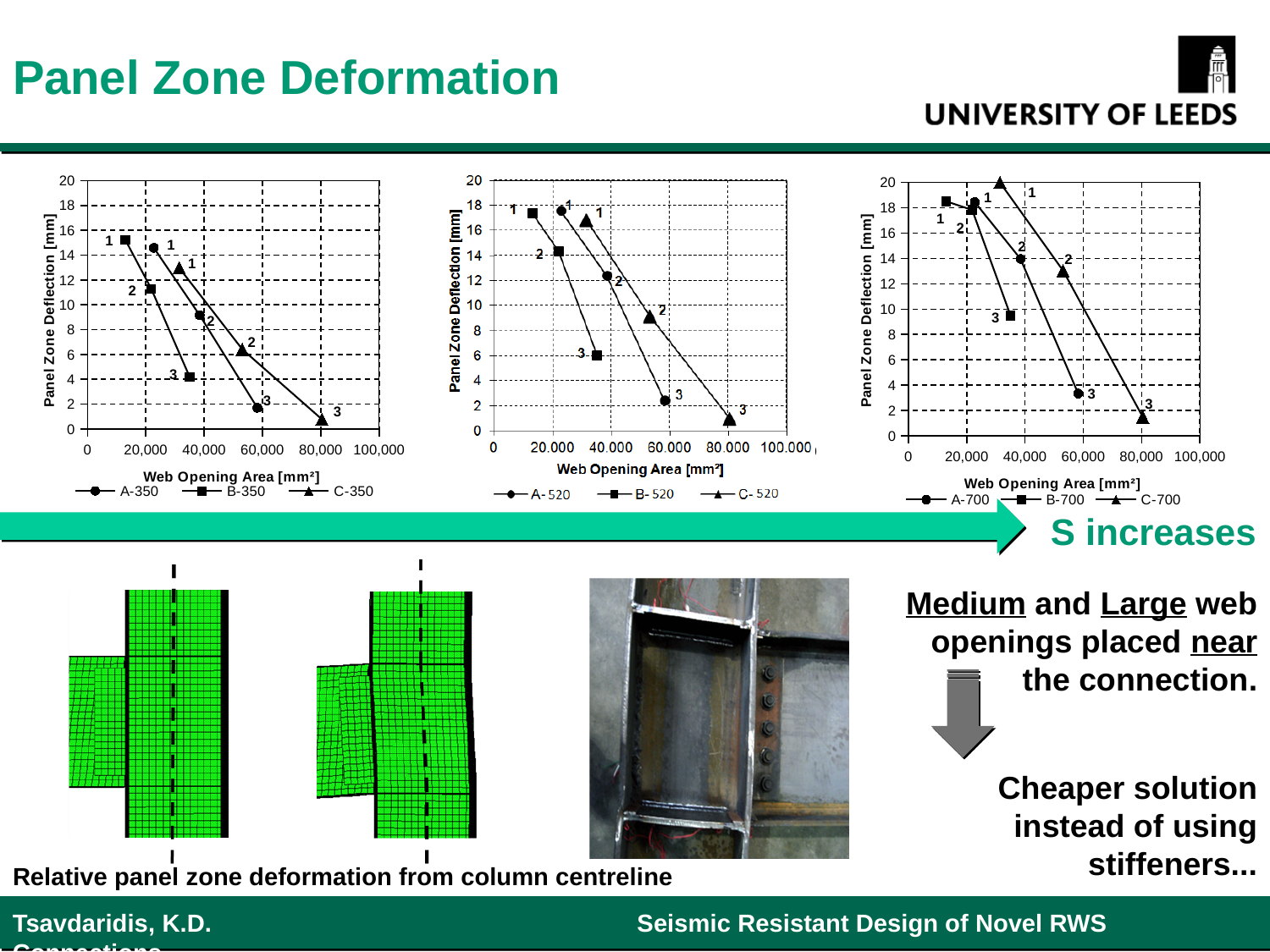
In the middle chart (A-520, B-520, C-520), is the panel zone deflection at point 1 of B-520 greater or less than 16? greater What is the x-axis title of the middle chart (A-520, B-520, C-520)? Web Opening Area [mm²] In the left chart (A-350, B-350, C-350), does panel zone deflection rise or fall as web opening area increases? fall In the right chart (A-700, B-700, C-700), how many data points are plotted for the C-700 series? 3 How many series does the legend of the middle chart (A-520, B-520, C-520) list? 3 In the left chart (A-350, B-350, C-350), is the panel zone deflection at point 1 of C-350 greater or less than 10? greater In the right chart (A-700, B-700, C-700), is the panel zone deflection at point 3 of A-700 greater or less than 6? less In the left chart (A-350, B-350, C-350), which series reaches the largest web opening area at point 3? C-350 What kind of chart is the left chart (A-350, B-350, C-350)? line chart In the middle chart (A-520, B-520, C-520), which has the larger panel zone deflection at point 3: A-520 or B-520? B-520 In the right chart (A-700, B-700, C-700), which series has the highest panel zone deflection at point 1? C-700